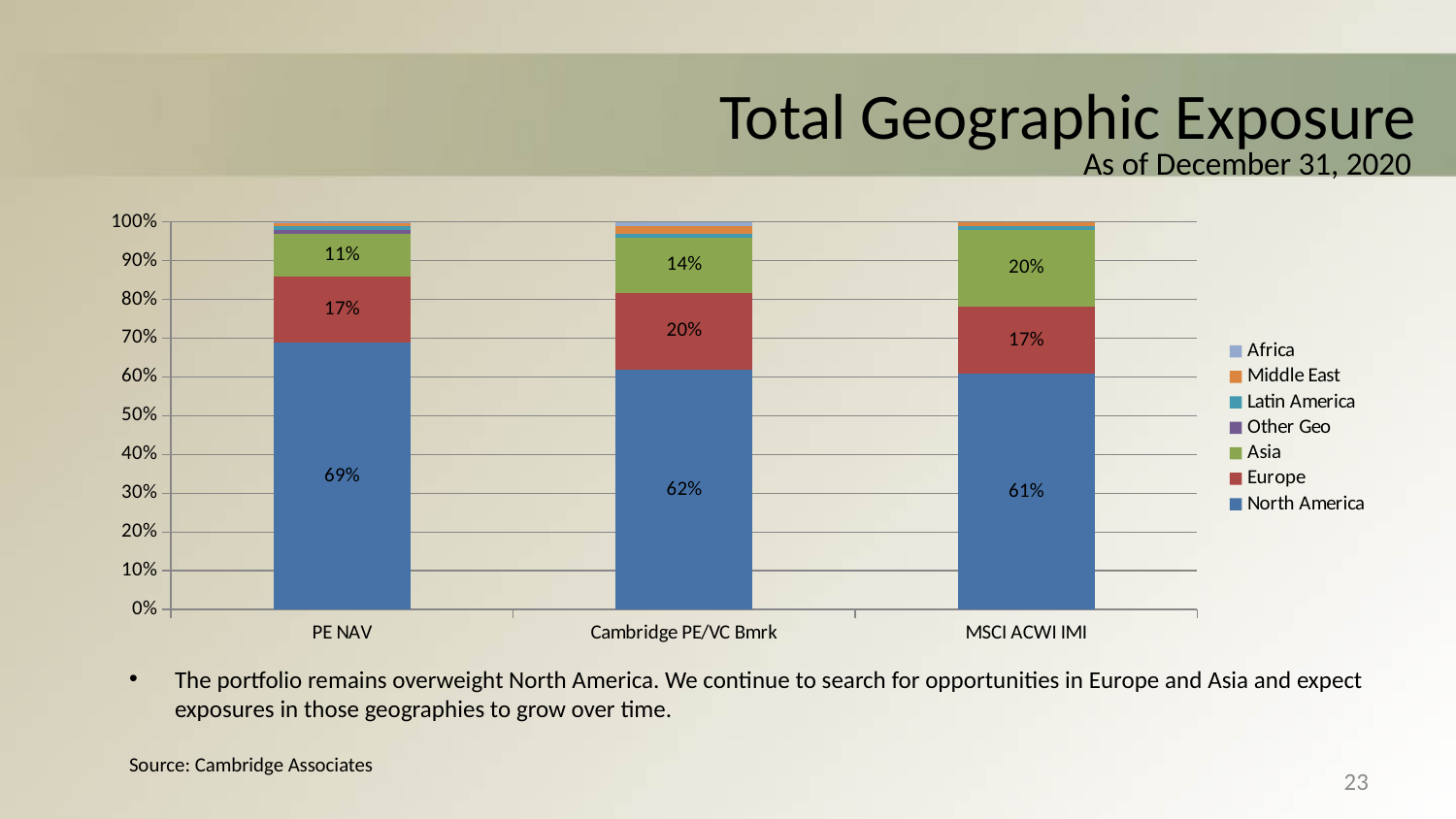
Which category has the highest North America share? PE NAV What is the Europe share for Cambridge PE/VC Bmrk? 20% What kind of chart is shown on the slide? Stacked bar chart What is the difference between the North America share for PE NAV and for MSCI ACWI IMI? 8% Which category has the lowest Asia share? PE NAV What is the Asia share for PE NAV? 11% How many series does the legend list? 7 How many categories are shown on the x axis? 3 What is the Asia share for MSCI ACWI IMI? 20% What is the title of the chart? Total Geographic Exposure Which is larger, the Europe share for Cambridge PE/VC Bmrk or the Europe share for MSCI ACWI IMI? Cambridge PE/VC Bmrk What is the North America share for PE NAV? 69%